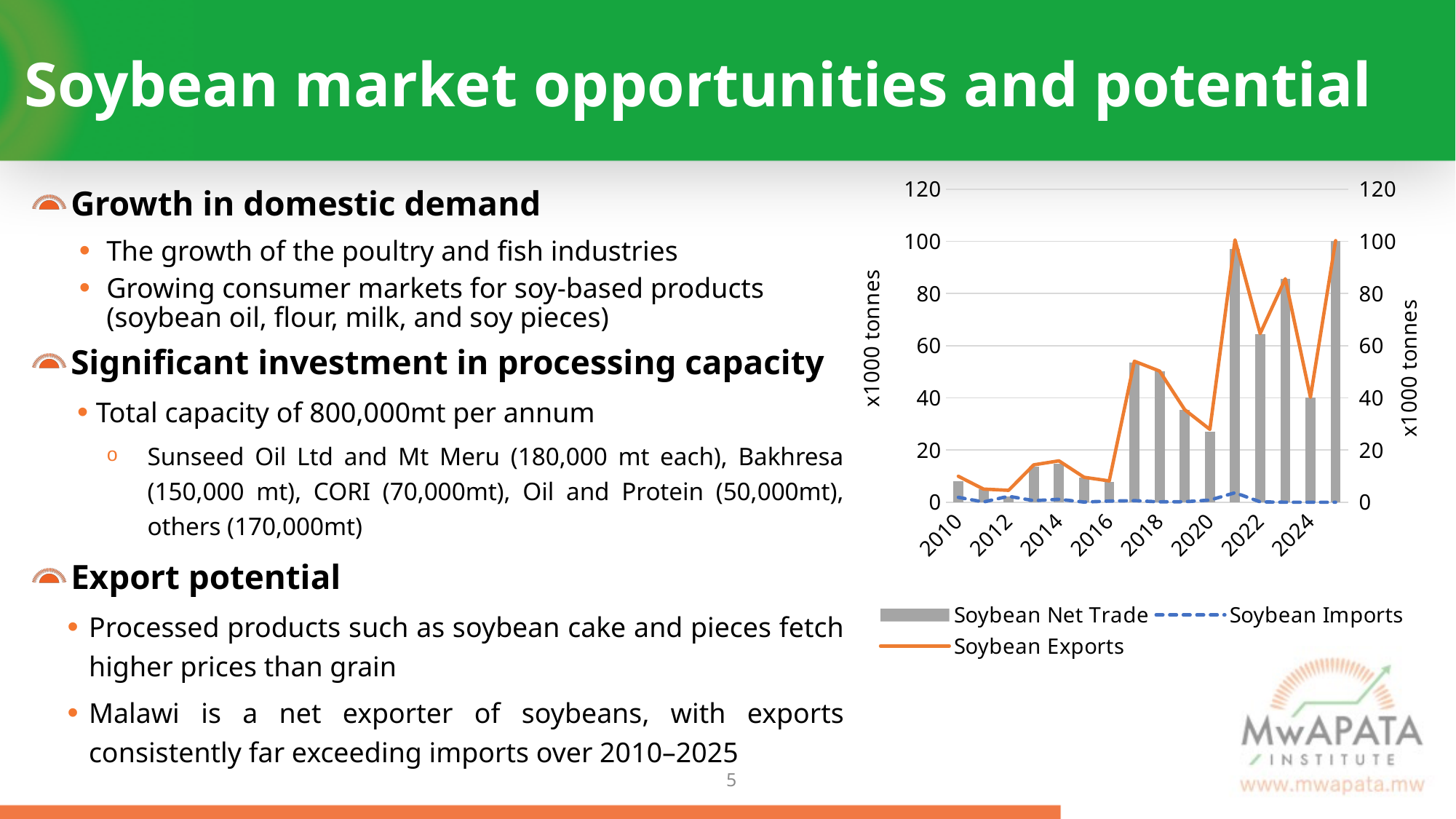
What is the label on the chart's vertical axis? x1000 tonnes Is the Soybean Net Trade value for 2024 greater or less than 60? less How many series does the chart legend list? 3 In 2021, which is larger, Soybean Exports or Soybean Imports? Soybean Exports Which series is drawn as bars in the chart? Soybean Net Trade Is the Soybean Imports value for 2021 greater or less than 20? less Is the Soybean Exports value for 2016 greater or less than 20? less Which year has the larger Soybean Exports value, 2021 or 2022? 2021 Do Soybean Exports rise or fall from 2016 to 2017? rise What kind of chart is shown on the slide? A combined bar and line chart